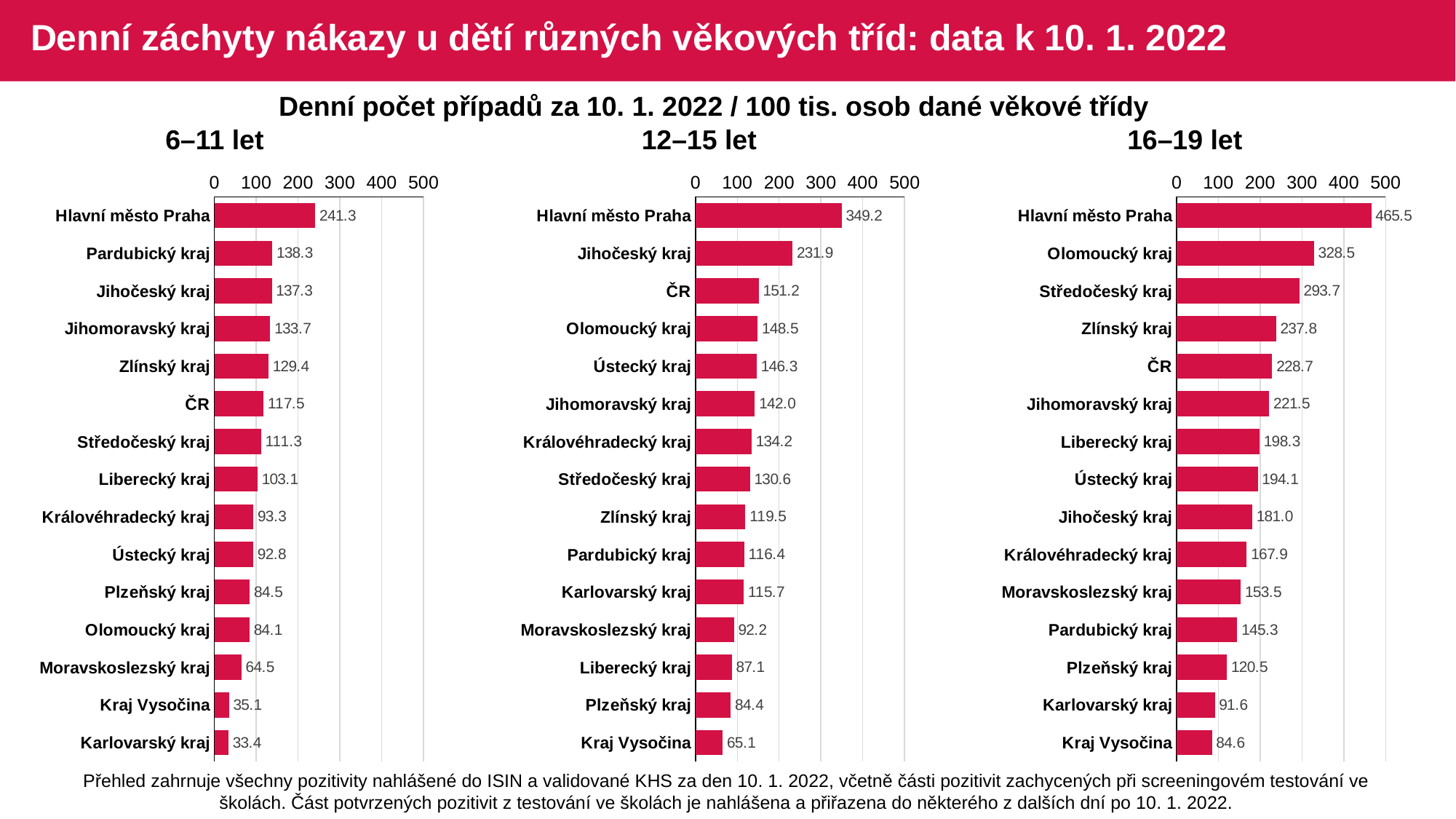
In the 12–15 let chart, what is the value for Jihočeský kraj? 231.9 In the 6–11 let chart, which category has the lowest value? Karlovarský kraj In the 12–15 let chart, which category has the lowest value? Kraj Vysočina In the 6–11 let chart, is the value for Pardubický kraj greater or less than 100? greater What is the value for ČR in the 16–19 let chart? 228.7 In the 16–19 let chart, what is the value for Olomoucký kraj? 328.5 What kind of chart is the 6–11 let chart? bar chart In the 16–19 let chart, which is larger, Zlínský kraj or Liberecký kraj? Zlínský kraj How many categories are shown in the 12–15 let chart? 15 In the 16–19 let chart, which category has the highest value? Hlavní město Praha In the 12–15 let chart, what is the difference between Hlavní město Praha and ČR? 198.0 In the 6–11 let chart, what is the value for Hlavní město Praha? 241.3